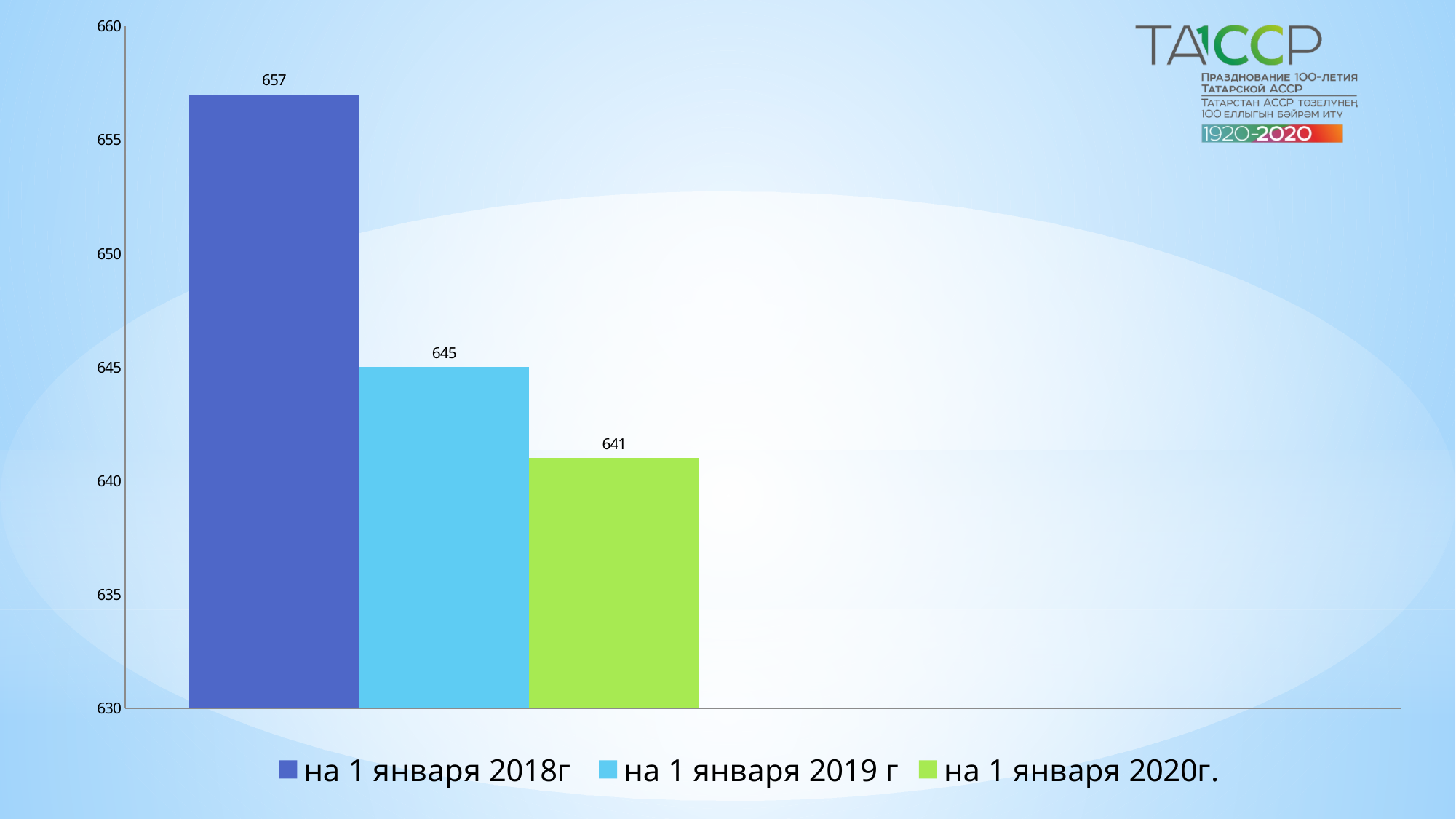
What is the value for "на 1 января 2020г."? 641 What is the difference between the values for "на 1 января 2018г" and "на 1 января 2020г."? 16 What is the difference between the values for "на 1 января 2019 г" and "на 1 января 2020г."? 4 Which is larger, the value for "на 1 января 2018г" or for "на 1 января 2019 г"? на 1 января 2018г What kind of chart is shown on the slide? bar chart Is the value for "на 1 января 2019 г" greater or less than 650? less Which series has the highest value? на 1 января 2018г Do the values rise or fall from the 2018 bar to the 2020 bar? fall Which series has the lowest value? на 1 января 2020г. How many series does the legend list? 3 What is the value for "на 1 января 2018г"? 657 What is the value for "на 1 января 2019 г"? 645